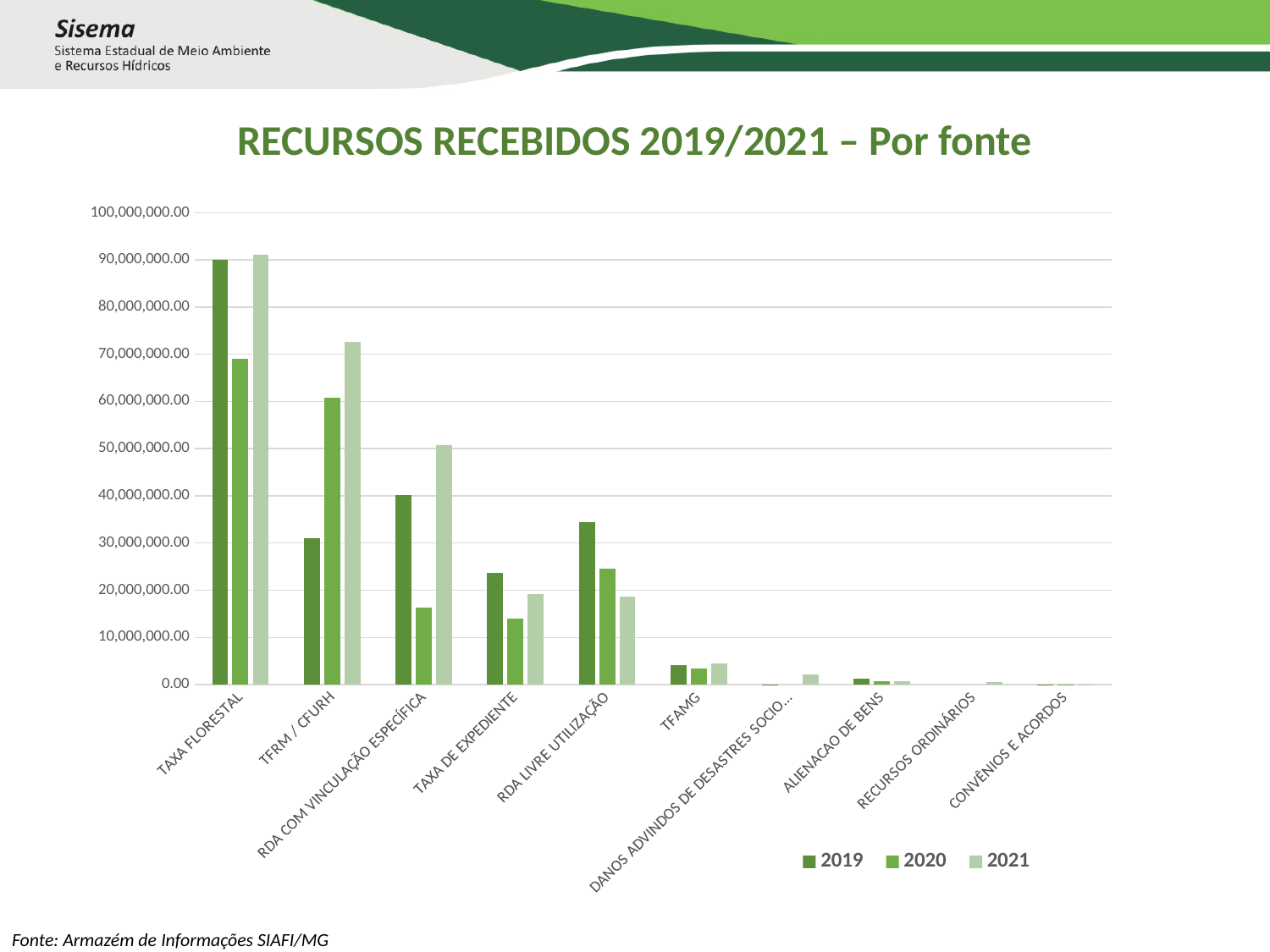
Do the values for TFRM / CFURH rise or fall from 2019 to 2021? rise Is the 2021 value for RDA COM VINCULAÇÃO ESPECÍFICA greater or less than 40,000,000.00? greater What is the title of the chart? RECURSOS RECEBIDOS 2019/2021 – Por fonte Which year has the lowest value for TAXA FLORESTAL? 2020 Which category has the highest value for 2021? TAXA FLORESTAL Is the 2021 value for TFRM / CFURH greater or less than 70,000,000.00? greater For RDA LIVRE UTILIZAÇÃO, which is larger: the 2019 value or the 2021 value? 2019 For TFRM / CFURH, which is larger: the 2019 value or the 2020 value? 2020 What kind of chart is shown on the slide? Bar chart How many series does the legend list? 3 How many categories are shown on the x axis? 10 Is the 2020 value for TAXA DE EXPEDIENTE greater or less than 20,000,000.00? less